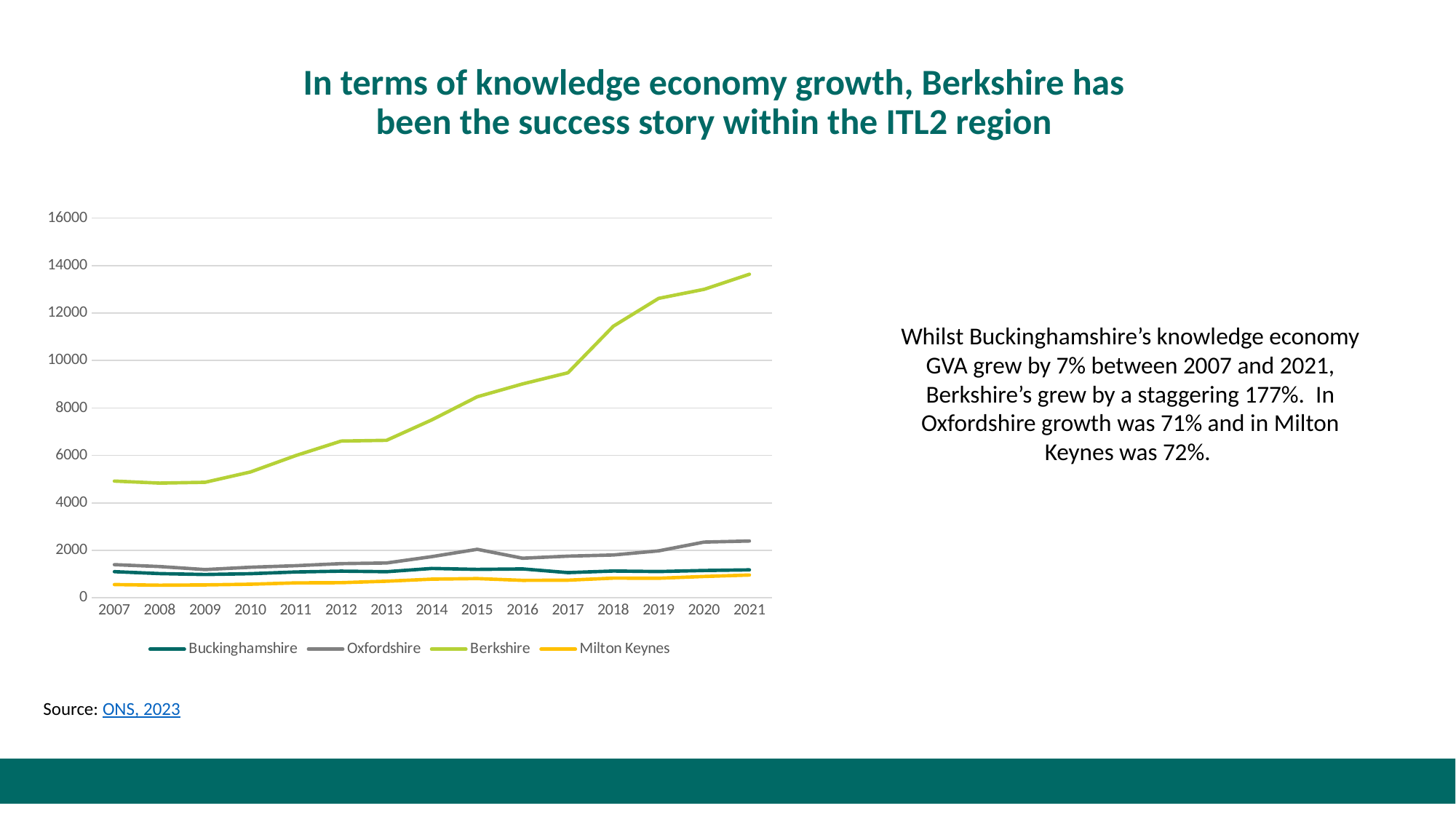
Does the Berkshire line rise or fall from 2007 to 2021? rise Which series has the highest value in 2021? Berkshire What kind of chart is shown on the slide? line chart How many series does the legend list? 4 Is the value for Milton Keynes in 2021 greater or less than 2000? less Which series has the lowest value in 2007? Milton Keynes What colour is the Berkshire line in the legend? light green Is the value for Berkshire in 2021 greater or less than 12000? greater Is the value for Oxfordshire in 2021 greater or less than 2000? greater How many years are shown along the x axis? 15 In 2021, which is larger: the value for Oxfordshire or the value for Buckinghamshire? Oxfordshire